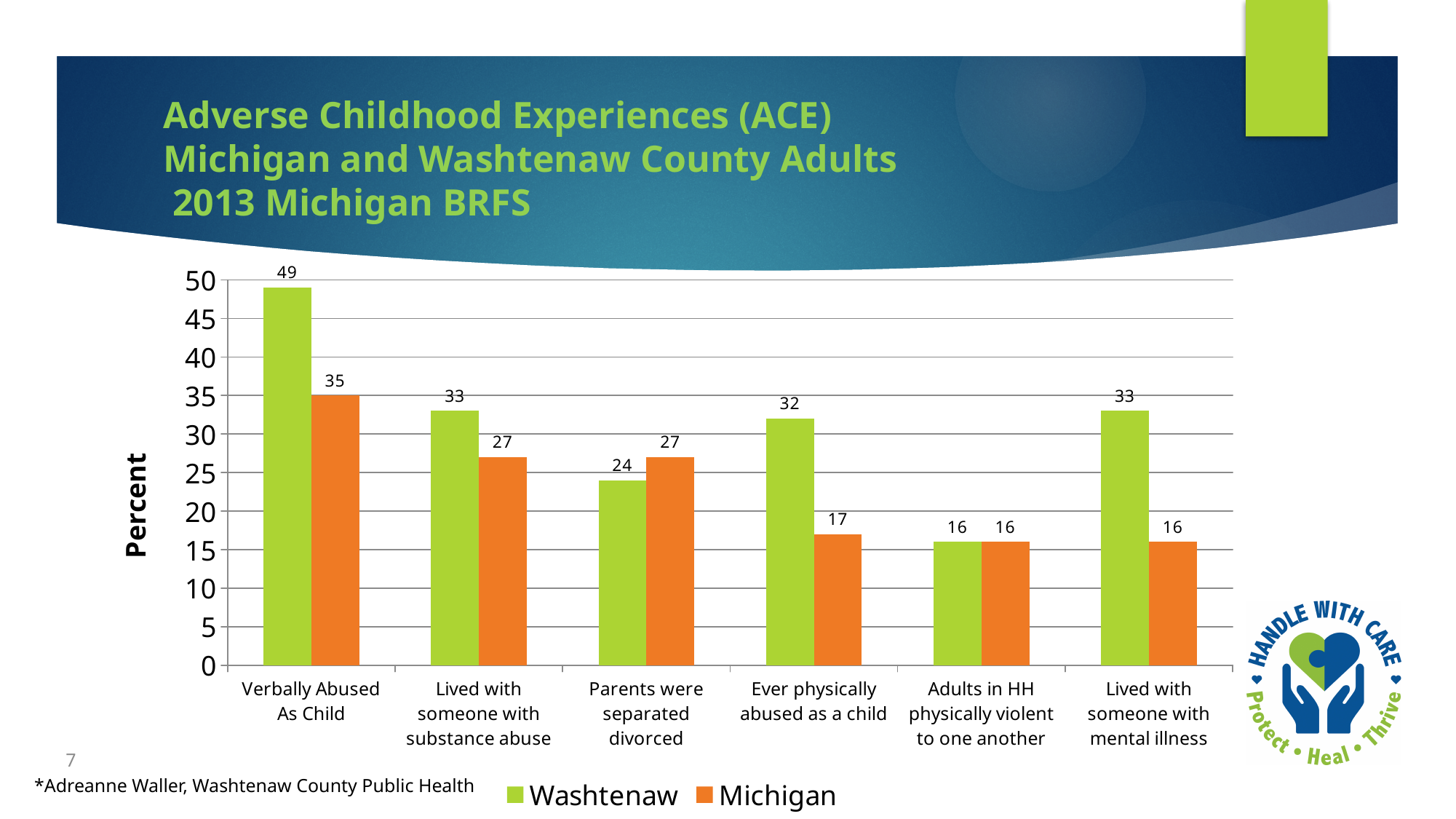
Which category has the highest Washtenaw value? Verbally Abused As Child What kind of chart is shown on the slide? Bar chart What is the difference between the Washtenaw and Michigan values for Verbally Abused As Child? 14 What is the difference between the Washtenaw and Michigan values for Lived with someone with mental illness? 17 What is the Washtenaw value for Verbally Abused As Child? 49 What is the label of the y axis? Percent Which category has the lowest Washtenaw value? Adults in HH physically violent to one another What is the Michigan value for Parents were separated divorced? 27 For Parents were separated divorced, which series has the larger value, Washtenaw or Michigan? Michigan How many categories are shown on the x axis? 6 What is the Michigan value for Ever physically abused as a child? 17 How many series does the legend list? 2